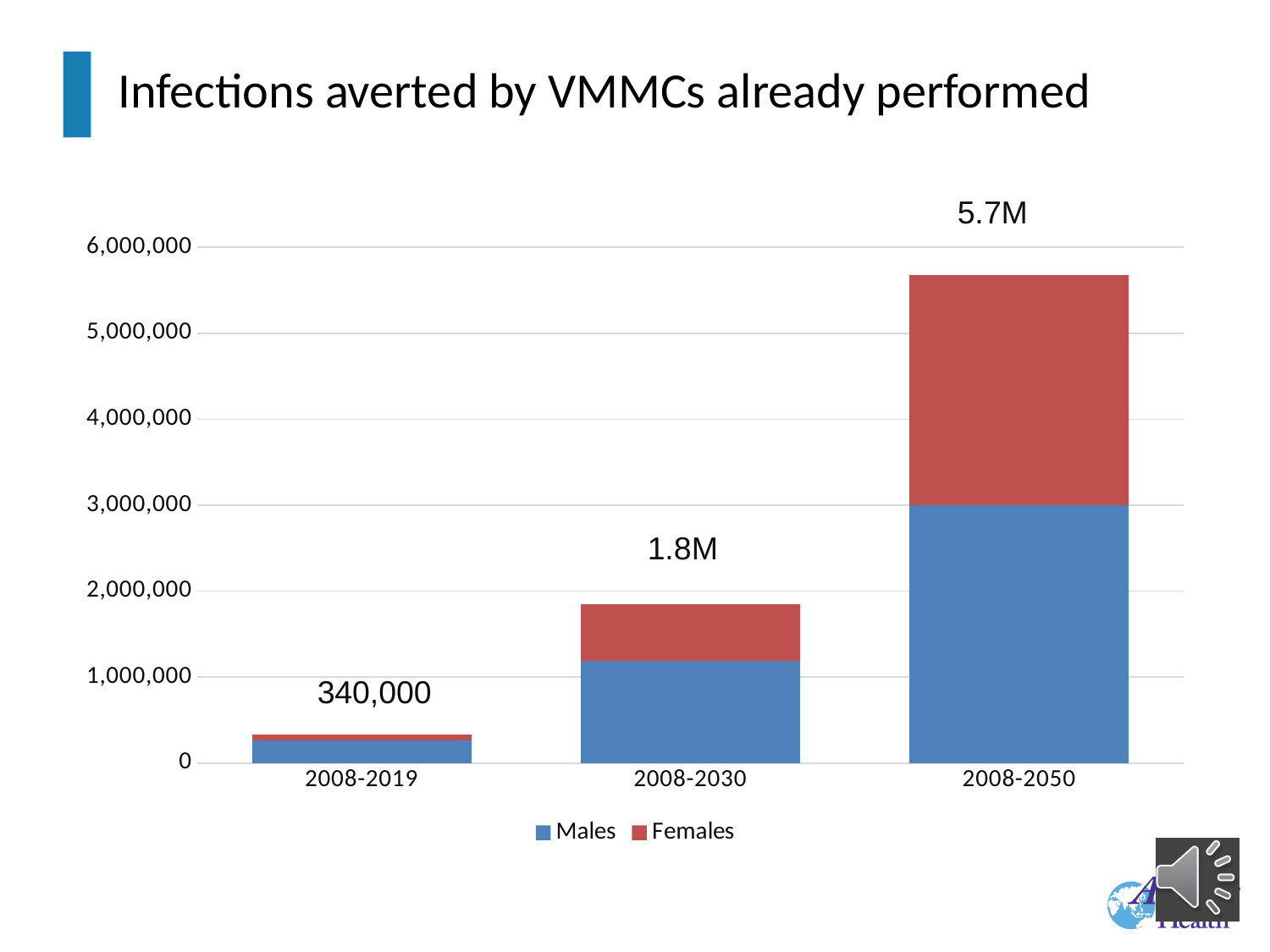
Is the Males value for 2008-2030 greater or less than 1,000,000? greater What is the total number of infections averted labelled for 2008-2050? 5.7M Do the total infections averted rise or fall from 2008-2019 to 2008-2050? rise Which has a larger total of infections averted, 2008-2019 or 2008-2030? 2008-2030 How many series does the legend list? 2 What kind of chart is shown on the slide? bar chart Which period has the highest total of infections averted? 2008-2050 How many time-period categories are shown on the x axis? 3 What are the two series named in the legend? Males and Females What is the total number of infections averted labelled for 2008-2030? 1.8M What is the total number of infections averted labelled for 2008-2019? 340,000 Which period has the lowest total of infections averted? 2008-2019